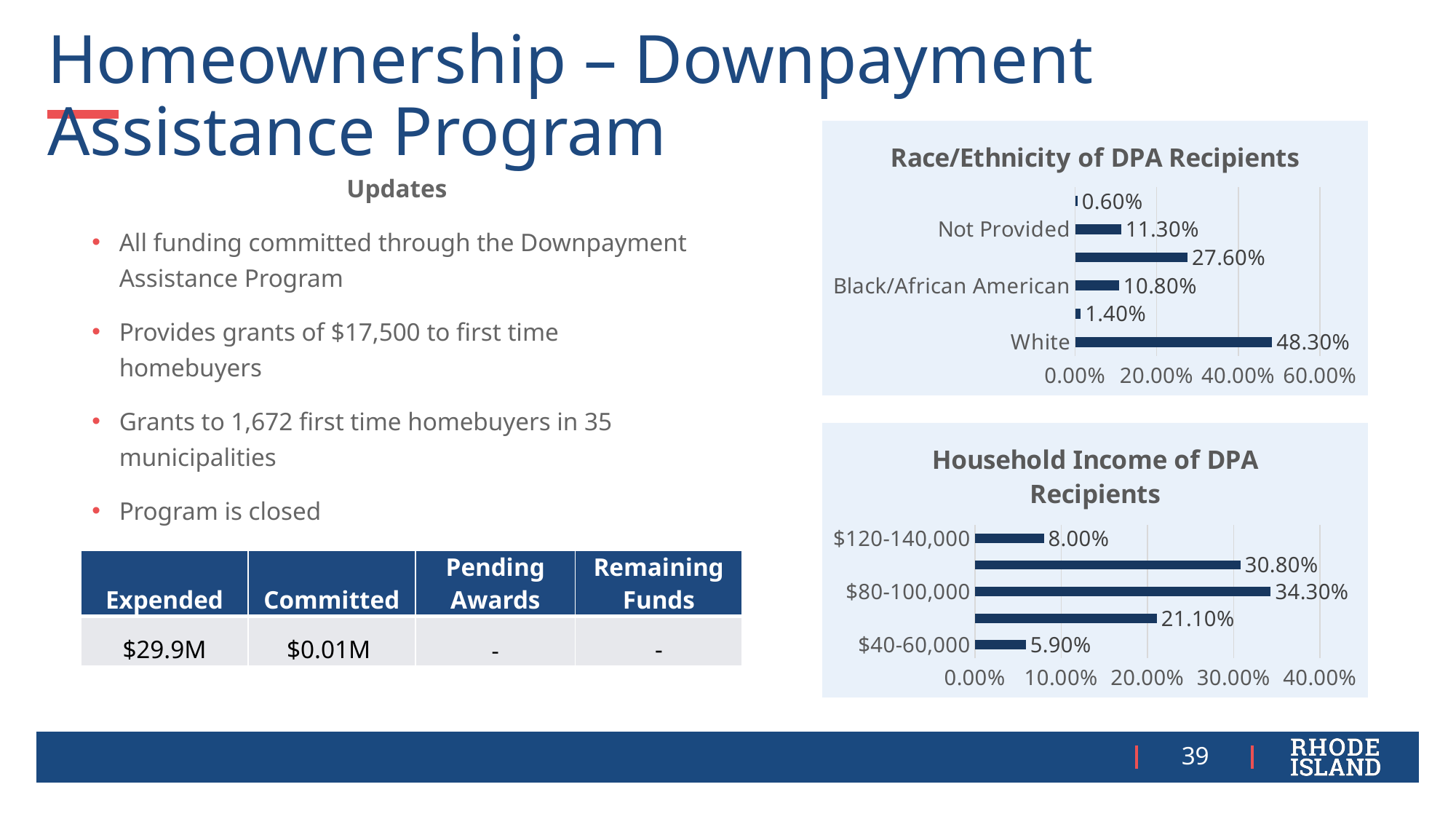
In the Race/Ethnicity of DPA Recipients chart, which category has the highest value? White In the Household Income of DPA Recipients chart, what is the value for $80-100,000? 34.30% In the Race/Ethnicity of DPA Recipients chart, what percentage of recipients are Black/African American? 10.80% In the Household Income of DPA Recipients chart, which income category has the lowest value? $40-60,000 In the Race/Ethnicity of DPA Recipients chart, what is the difference between the White and Black/African American values? 37.50% In the Household Income of DPA Recipients chart, what is the difference between the $80-100,000 and $120-140,000 values? 26.30% In the Race/Ethnicity of DPA Recipients chart, which is larger: Not Provided or Black/African American? Not Provided In the Household Income of DPA Recipients chart, what is the value for $40-60,000? 5.90% In the Race/Ethnicity of DPA Recipients chart, what percentage of recipients are White? 48.30% What type of chart is the Household Income of DPA Recipients chart? Bar chart How many bars are plotted in the Race/Ethnicity of DPA Recipients chart? 6 In the Race/Ethnicity of DPA Recipients chart, what is the value for Not Provided? 11.30%